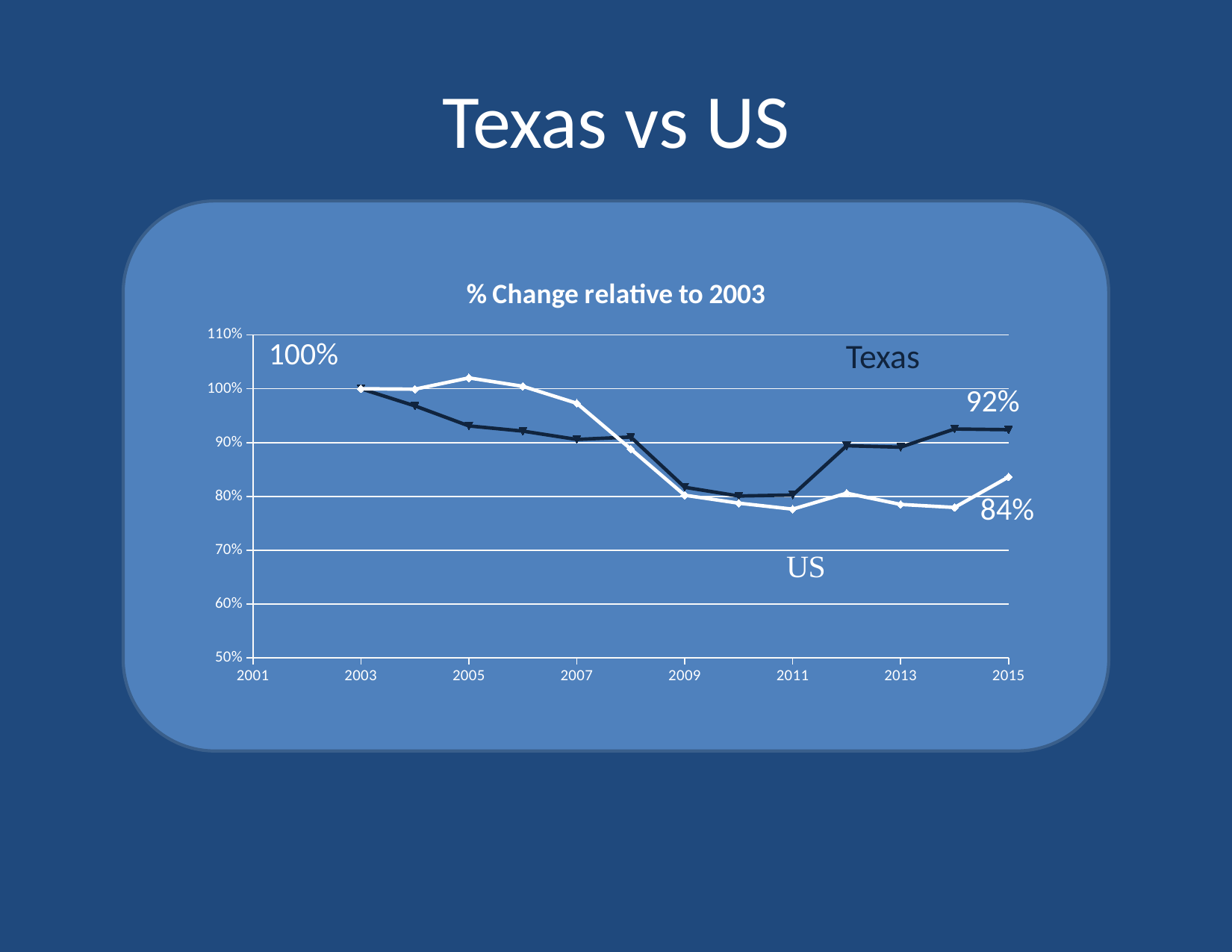
How many series are plotted on the chart? 2 Which series has the higher value in 2015, Texas or US? Texas What is the difference between the Texas and US values in 2015? 8 percentage points What is the labelled value for Texas in 2015? 92% Overall, do the values rise or fall from 2003 to 2015? fall Is the value for US in 2011 greater or less than 80%? less Which series is drawn with the white line? US What value do both series start at in 2003? 100% What is the labelled value for US in 2015? 84% What kind of chart is shown on the slide? line chart What is the title of the chart? % Change relative to 2003 Is the value for Texas in 2007 greater or less than 100%? less